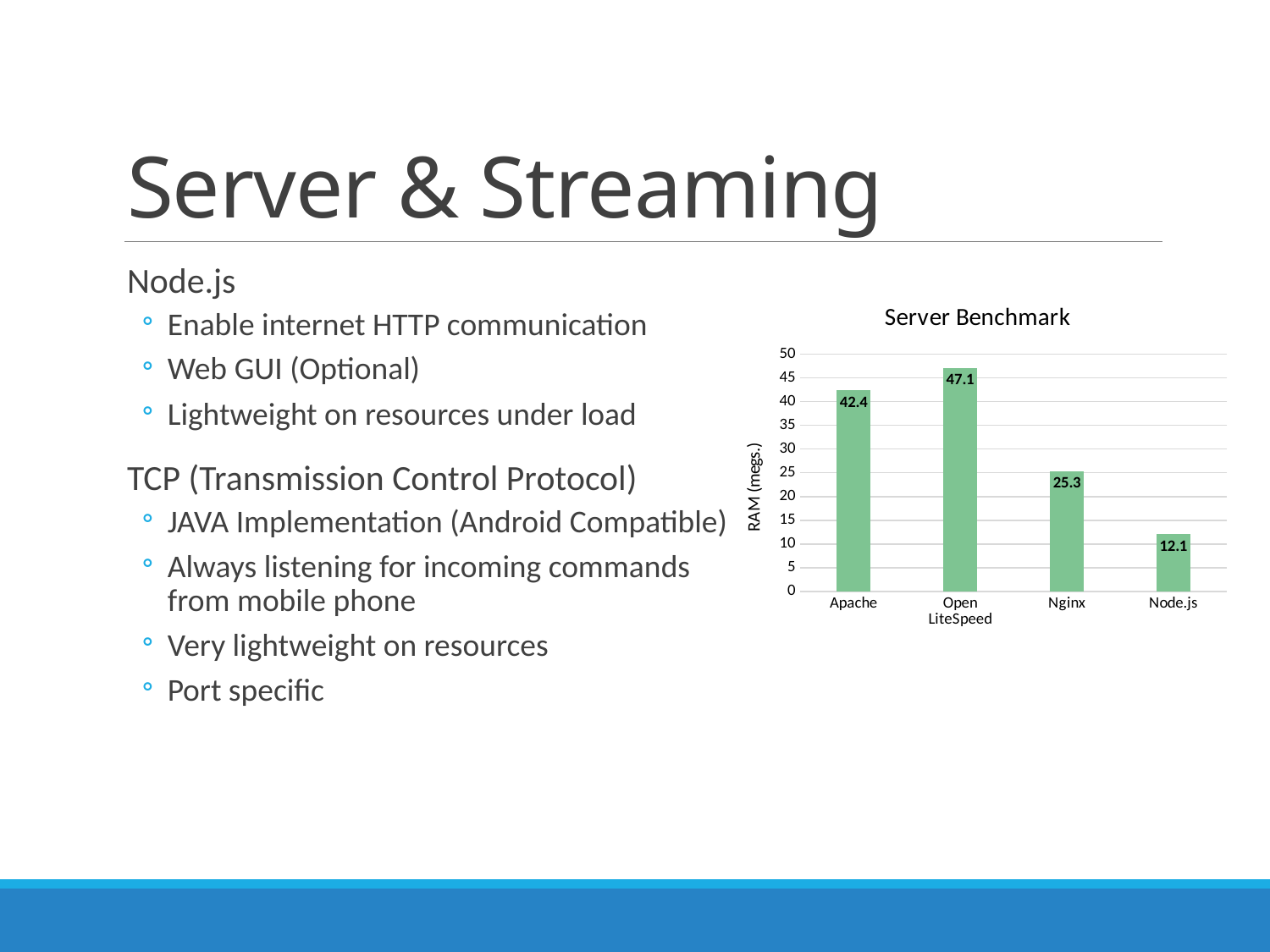
What is the label of the y-axis in the Server Benchmark chart? RAM (megs.) Which uses more RAM, Apache or Nginx? Apache How many servers are compared in the Server Benchmark chart? 4 What is the RAM value for Apache in the Server Benchmark chart? 42.4 What is the difference in RAM usage between Apache and Nginx? 17.1 Which server has the lowest RAM usage in the Server Benchmark chart? Node.js What is the RAM value for Node.js in the Server Benchmark chart? 12.1 Which server has the highest RAM usage in the Server Benchmark chart? Open LiteSpeed What is the difference in RAM usage between Open LiteSpeed and Node.js? 35 What is the RAM value for Nginx in the Server Benchmark chart? 25.3 What is the RAM value for Open LiteSpeed in the Server Benchmark chart? 47.1 What type of chart is the Server Benchmark chart? Bar chart